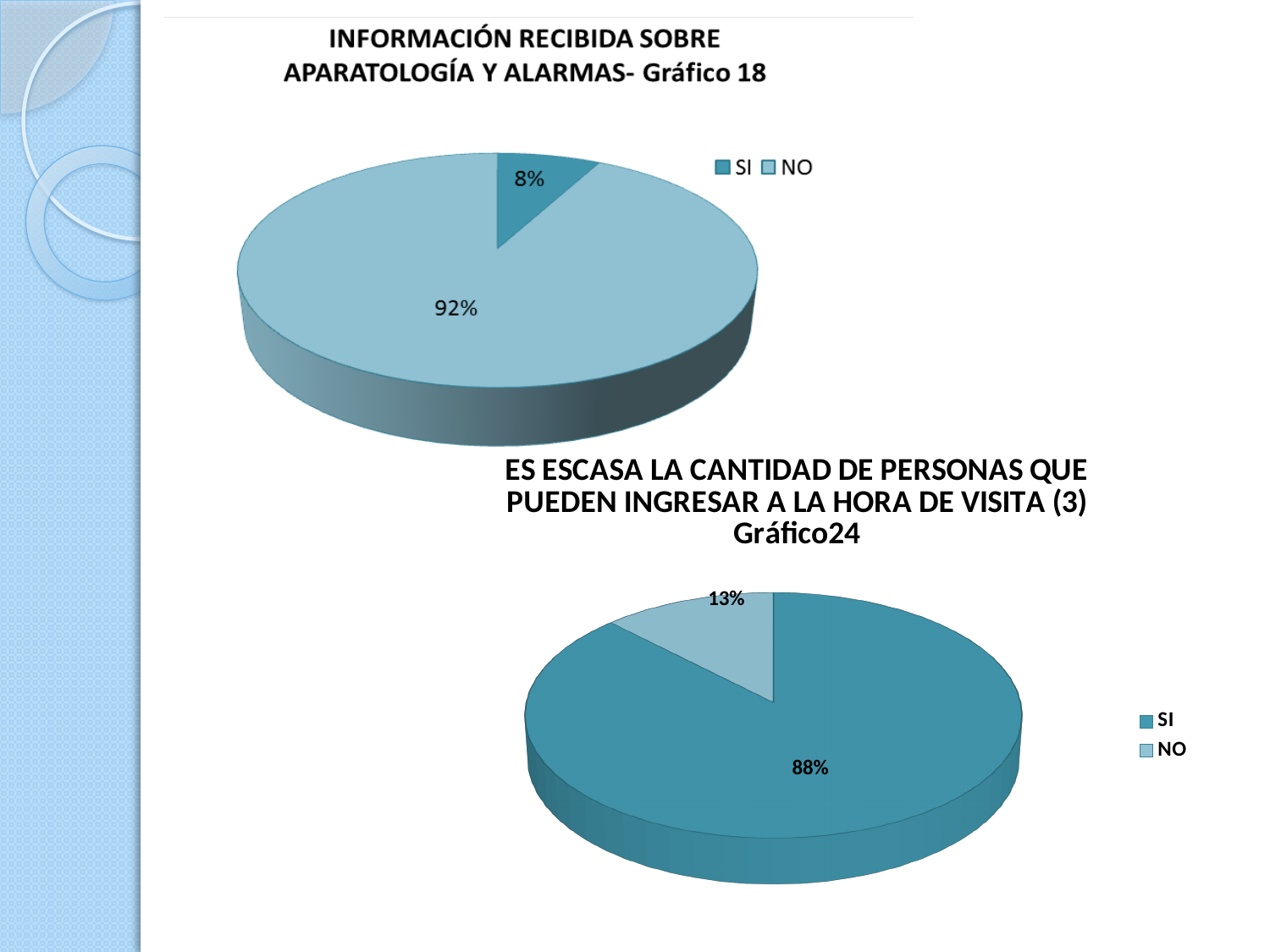
What kind of chart is the top chart on the slide (Gráfico 18)? Pie chart In the chart titled 'ES ESCASA LA CANTIDAD DE PERSONAS QUE PUEDEN INGRESAR A LA HORA DE VISITA (3) Gráfico24', which category has the smallest slice? NO In the chart titled 'INFORMACIÓN RECIBIDA SOBRE APARATOLOGÍA Y ALARMAS- Gráfico 18', what share of the pie is 'NO'? 92% How many charts are shown on the slide? 2 In the chart titled 'INFORMACIÓN RECIBIDA SOBRE APARATOLOGÍA Y ALARMAS- Gráfico 18', what is the difference between the 'NO' and 'SI' shares? 84% In the chart titled 'ES ESCASA LA CANTIDAD DE PERSONAS QUE PUEDEN INGRESAR A LA HORA DE VISITA (3) Gráfico24', what share of the pie is 'NO'? 13% In the chart titled 'ES ESCASA LA CANTIDAD DE PERSONAS QUE PUEDEN INGRESAR A LA HORA DE VISITA (3) Gráfico24', which is larger, 'SI' or 'NO'? SI In the chart titled 'INFORMACIÓN RECIBIDA SOBRE APARATOLOGÍA Y ALARMAS- Gráfico 18', how many entries does the legend list? 2 In the chart titled 'INFORMACIÓN RECIBIDA SOBRE APARATOLOGÍA Y ALARMAS- Gráfico 18', what share of the pie is 'SI'? 8% In the chart titled 'ES ESCASA LA CANTIDAD DE PERSONAS QUE PUEDEN INGRESAR A LA HORA DE VISITA (3) Gráfico24', how many slices does the pie have? 2 In the chart titled 'INFORMACIÓN RECIBIDA SOBRE APARATOLOGÍA Y ALARMAS- Gráfico 18', which category has the largest slice? NO